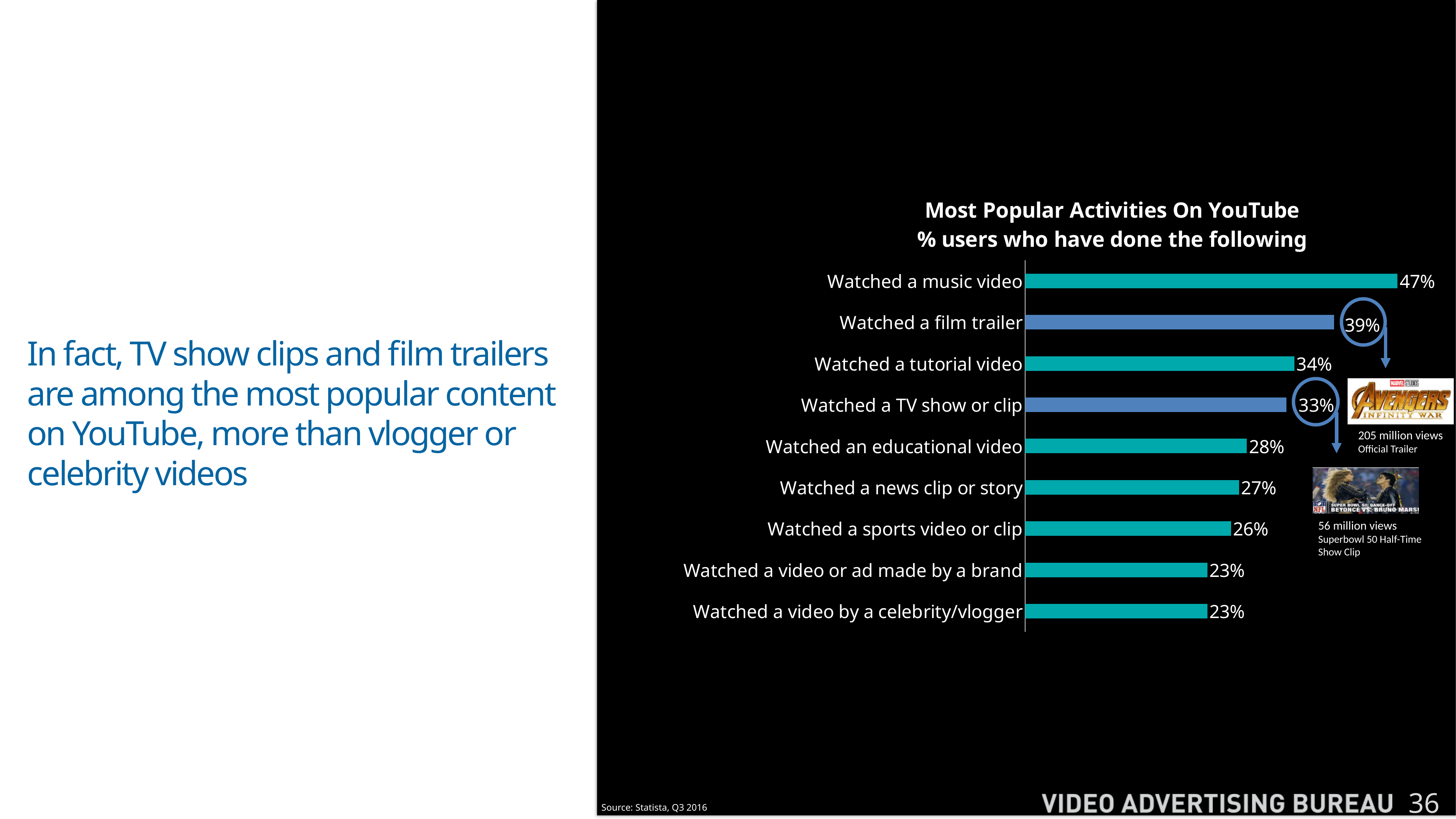
Which two bars are highlighted in a different (blue) colour from the rest? Watched a film trailer and Watched a TV show or clip Which has a higher percentage: watching a TV show or clip, or watching an educational video? Watched a TV show or clip What is the title of the chart? Most Popular Activities On YouTube Which activity has the highest percentage of users? Watched a music video What percentage of users have watched a film trailer on YouTube? 39% What percentage of users have watched a news clip or story on YouTube? 27% What is the difference in percentage points between watching a film trailer and watching a video by a celebrity/vlogger? 16 What percentage of users have watched a music video on YouTube? 47% What is the difference in percentage points between watching a music video and watching a tutorial video? 13 What percentage of users have watched a TV show or clip on YouTube? 33% How many activities are shown in the chart? 9 What type of chart is used to show the most popular activities on YouTube? Bar chart